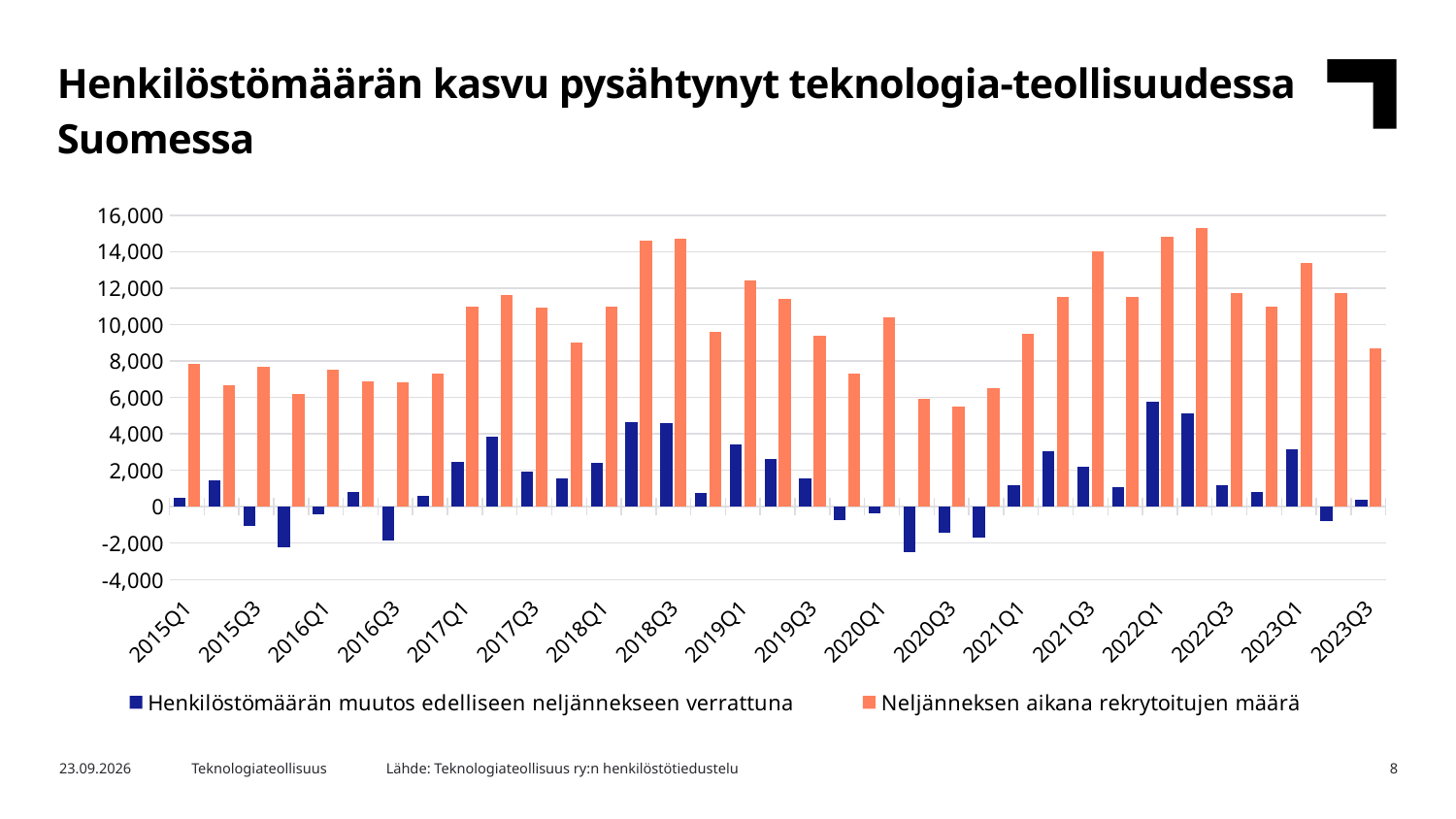
Which series is shown in orange? Neljänneksen aikana rekrytoitujen määrä Is the value of Neljänneksen aikana rekrytoitujen määrä for 2018Q3 greater or less than 14,000? greater What kind of chart is shown on the slide? Bar chart What is the title of the slide? Henkilöstömäärän kasvu pysähtynyt teknologia-teollisuudessa Suomessa How many series does the legend list? 2 Is the value of Neljänneksen aikana rekrytoitujen määrä for 2020Q3 greater or less than 6,000? less Which quarter has the highest value of Henkilöstömäärän muutos edelliseen neljännekseen verrattuna? 2022Q1 Is the value of Henkilöstömäärän muutos edelliseen neljännekseen verrattuna for 2022Q1 greater or less than 4,000? greater Which is larger, the value of Neljänneksen aikana rekrytoitujen määrä for 2018Q3 or for 2015Q1? 2018Q3